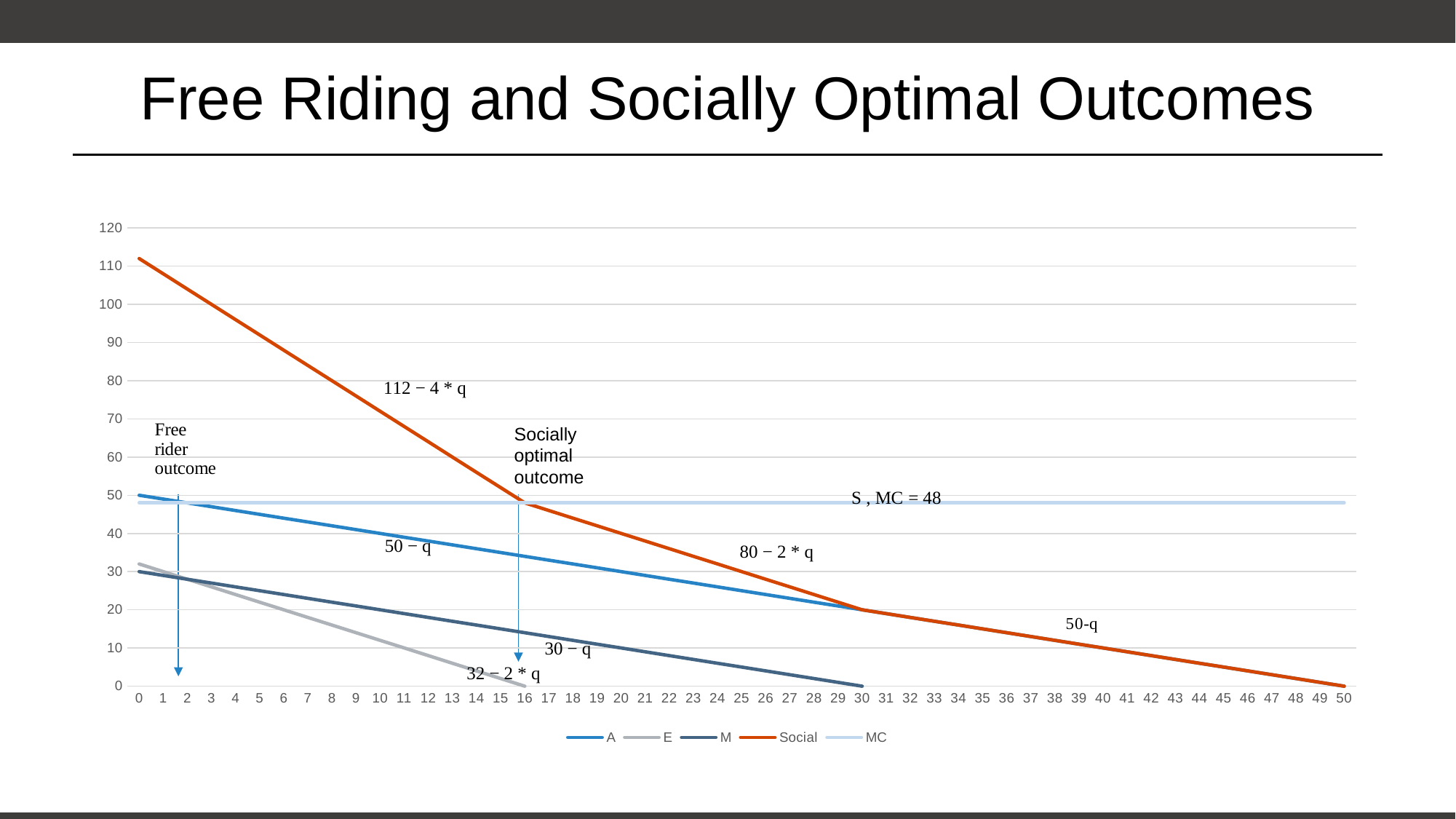
What formula is written next to the steepest segment of the Social line? 112 − 4 * q What is the value of the A line at q = 0? 50 Is the value of the A line at q = 30 greater or less than 30? less Is the value of the Social line at q = 10 greater or less than 70? greater What label is written at the point where the Social line meets the MC line? Socially optimal outcome Does the Social line rise or fall as q increases along the x axis? fall How many series does the legend list? 5 At q = 10, which is larger, the E line or the M line? M At q = 0, which is larger, the A line or the M line? A Which series has the highest value at q = 0? Social What is the value of the MC line, as labelled on the chart? 48 What kind of chart is shown on the slide? line chart